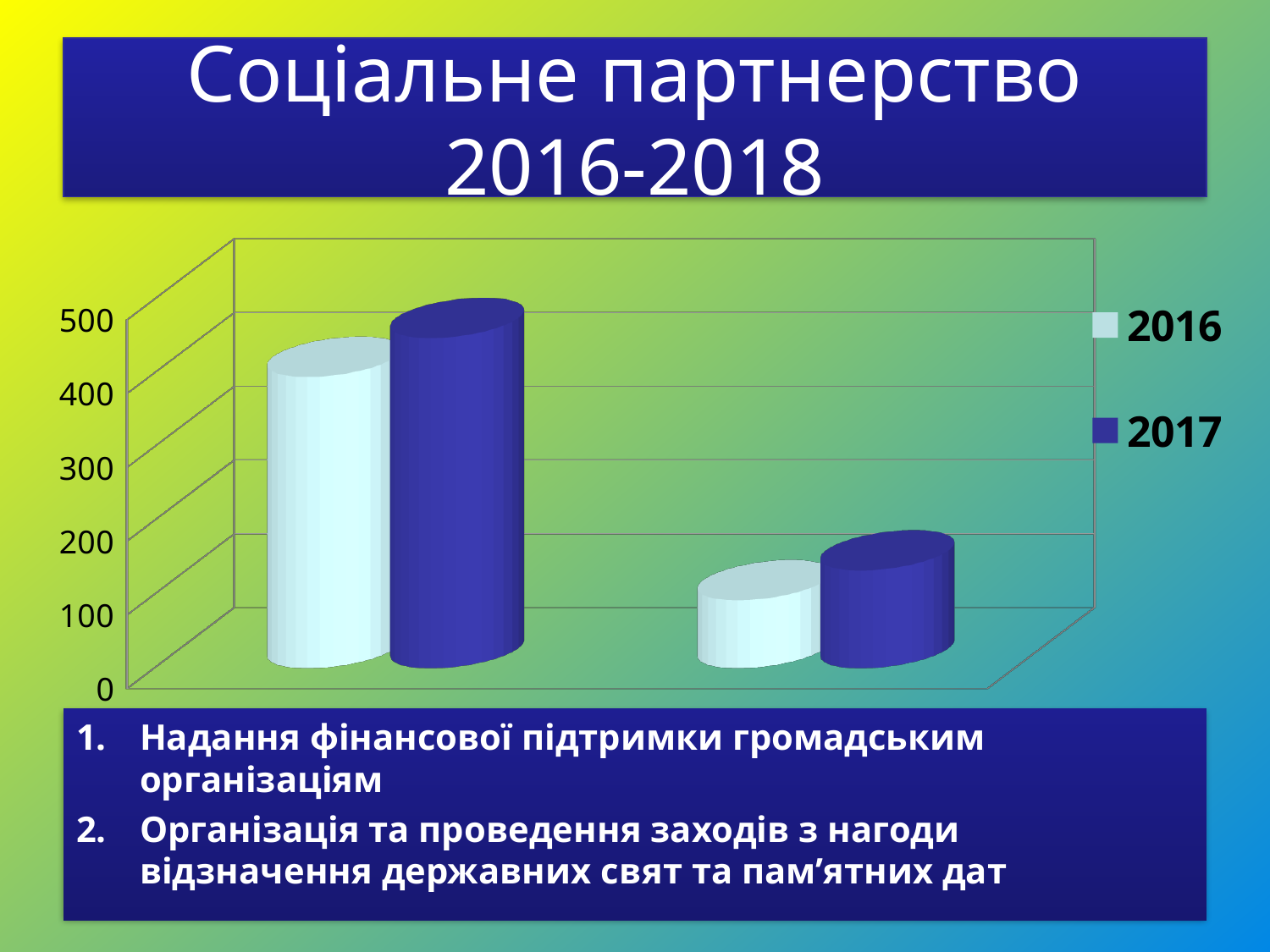
Which bar in the chart is the shortest overall? 2016 in the right group Is the 2016 value in the left group greater or less than 300? greater How many series does the chart legend list? 2 Is the 2017 value in the right group greater or less than 300? less In the left group of bars, which series has the larger value, 2016 or 2017? 2017 Is the 2016 value in the right group greater or less than 200? less How many groups of bars are plotted in the chart? 2 Which bar in the chart is the tallest overall? 2017 in the left group What kind of chart is shown on the slide? bar chart Which years are listed in the chart legend? 2016 and 2017 In the right group of bars, which series has the larger value, 2016 or 2017? 2017